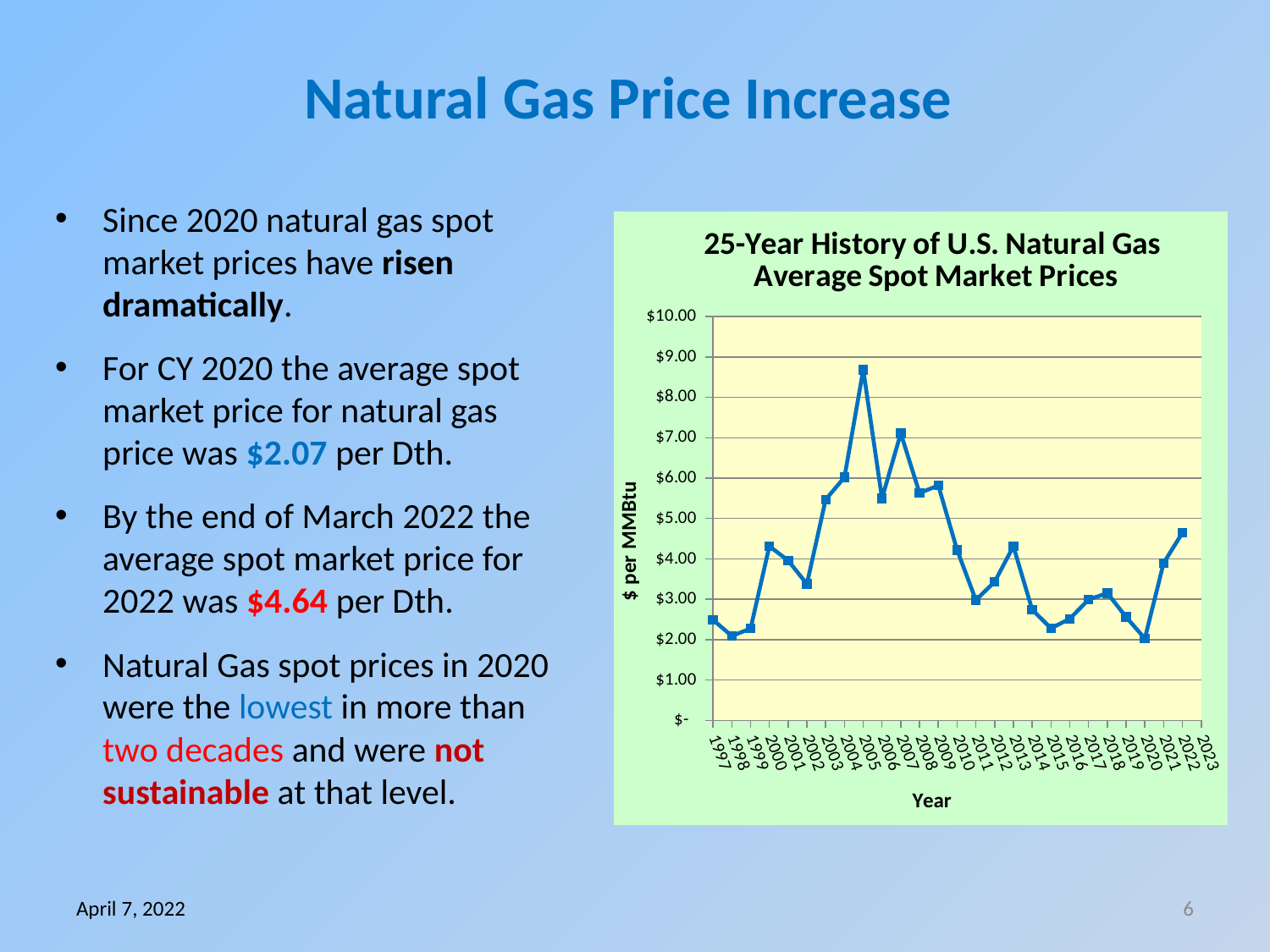
Is the value for 2004 greater or less than $5.00? greater Is the value for 2020 greater or less than $3.00? less Is the value for 2002 greater or less than $4.00? less Which year has the larger value, 2005 or 2007? 2005 What is the label on the vertical axis of the chart? $ per MMBtu Which year has the larger value, 2020 or 2022? 2022 Do the values rise or fall from 2020 to 2022? rise Which year has the highest average spot market price in the chart? 2005 What is the title of the chart? 25-Year History of U.S. Natural Gas Average Spot Market Prices What kind of chart is shown on the slide? line chart